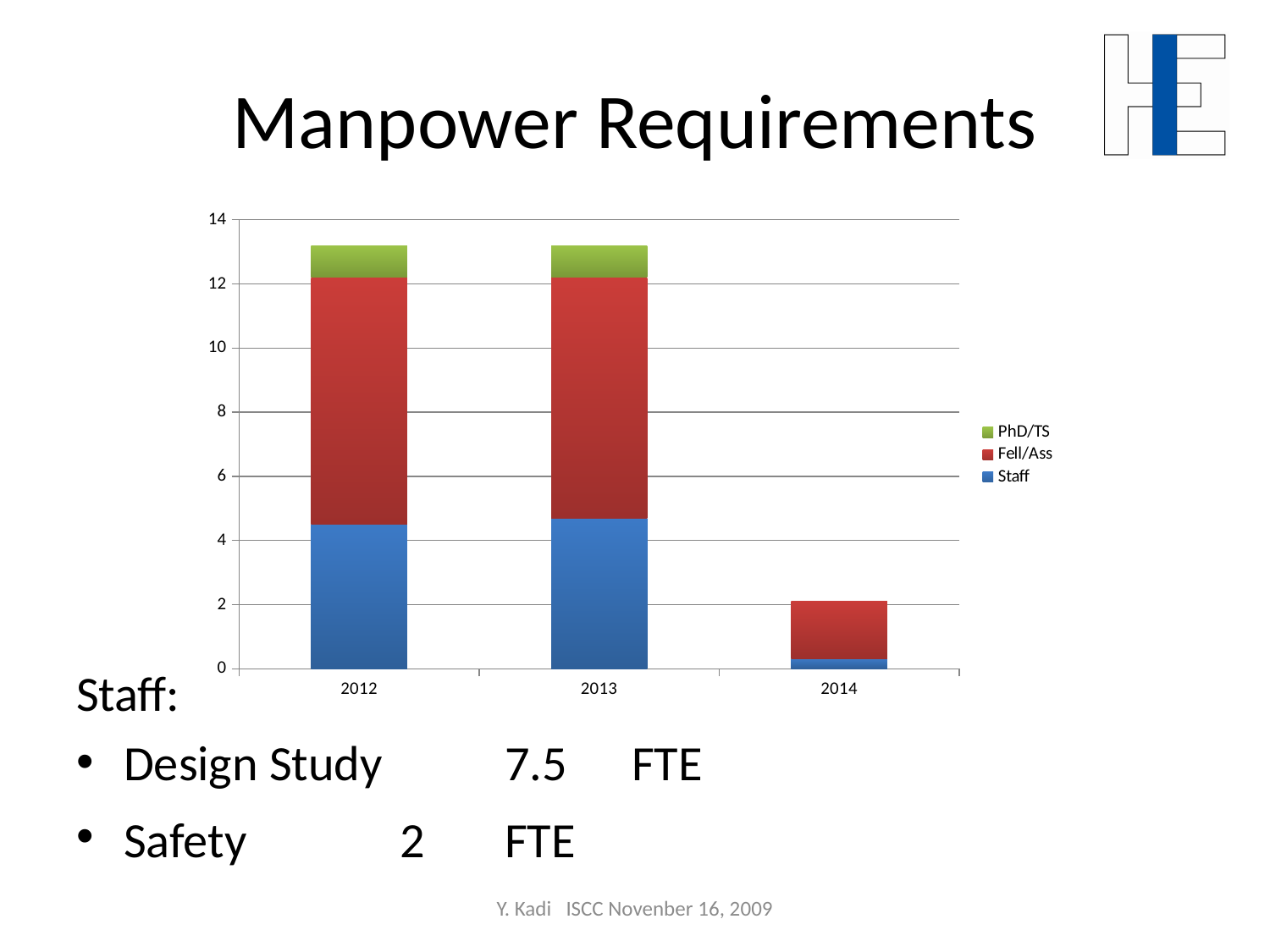
Is the Staff value for 2012 greater or less than 4? greater Which is larger, the Staff value for 2012 or the Staff value for 2014? 2012 Which is larger, the Fell/Ass value for 2013 or the Fell/Ass value for 2014? 2013 Is the total bar for 2014 greater or less than 4? less Which series is shown in blue at the bottom of each stacked bar? Staff What kind of chart is shown on the slide? stacked bar chart Which series is shown in green in the chart? PhD/TS Which year has the lowest total bar in the chart? 2014 Is the Staff value for 2014 greater or less than 2? less How many series does the chart legend list? 3 How many years are shown on the x axis of the chart? 3